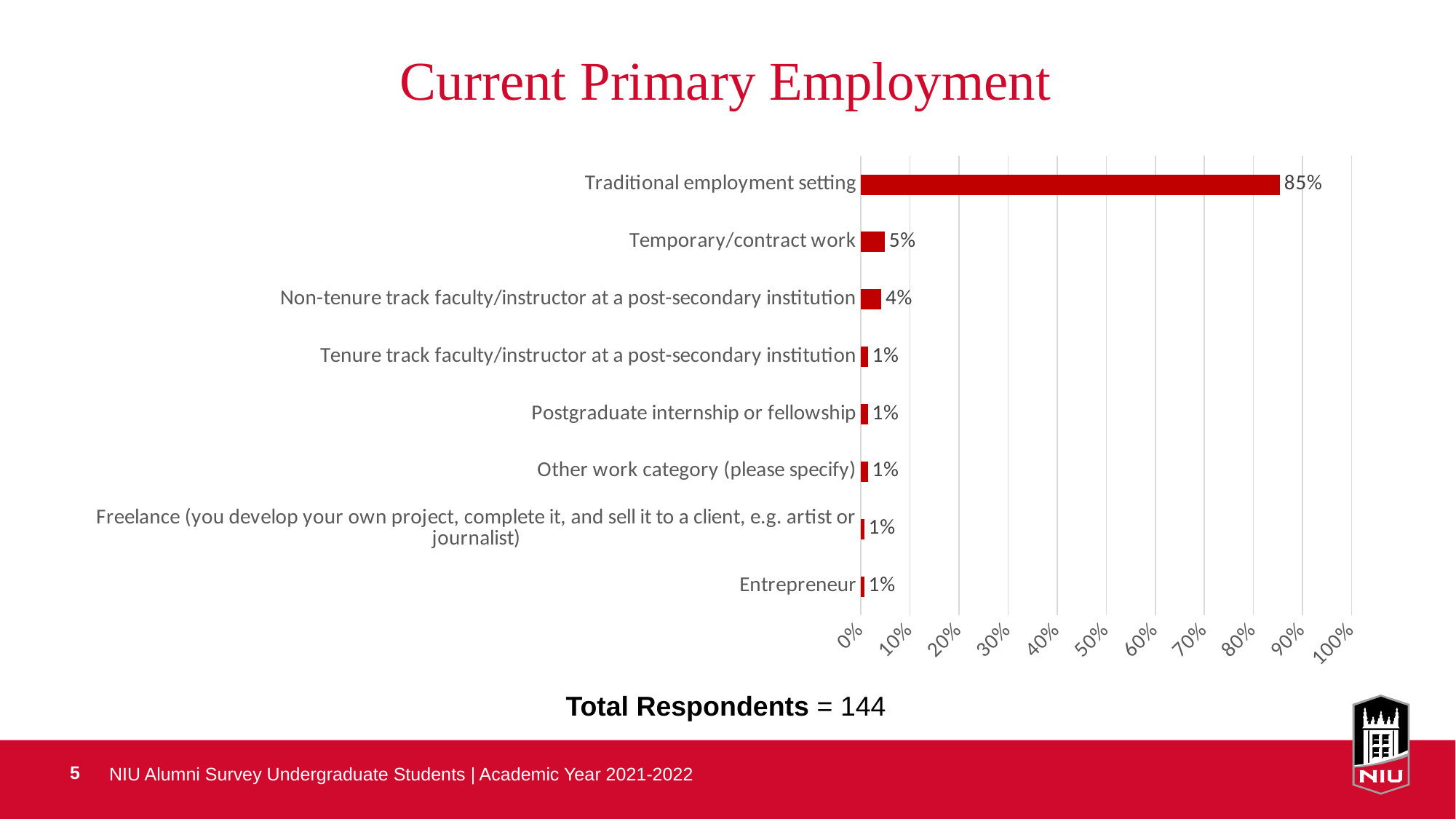
What percentage is shown for Non-tenure track faculty/instructor at a post-secondary institution? 4% Which is larger: Temporary/contract work or Non-tenure track faculty/instructor at a post-secondary institution? Temporary/contract work Is the value for Traditional employment setting greater or less than 80%? greater What kind of chart is shown on the slide? Bar chart What percentage of respondents reported a traditional employment setting as their current primary employment? 85% What is the value for Entrepreneur? 1% What is the difference between the values for Traditional employment setting and Temporary/contract work? 80% What is the total number of respondents stated below the chart? 144 How many categories are shown in the chart? 8 What is the value for Temporary/contract work? 5% Which category has the highest value? Traditional employment setting What is the difference between Temporary/contract work and Non-tenure track faculty/instructor at a post-secondary institution? 1%